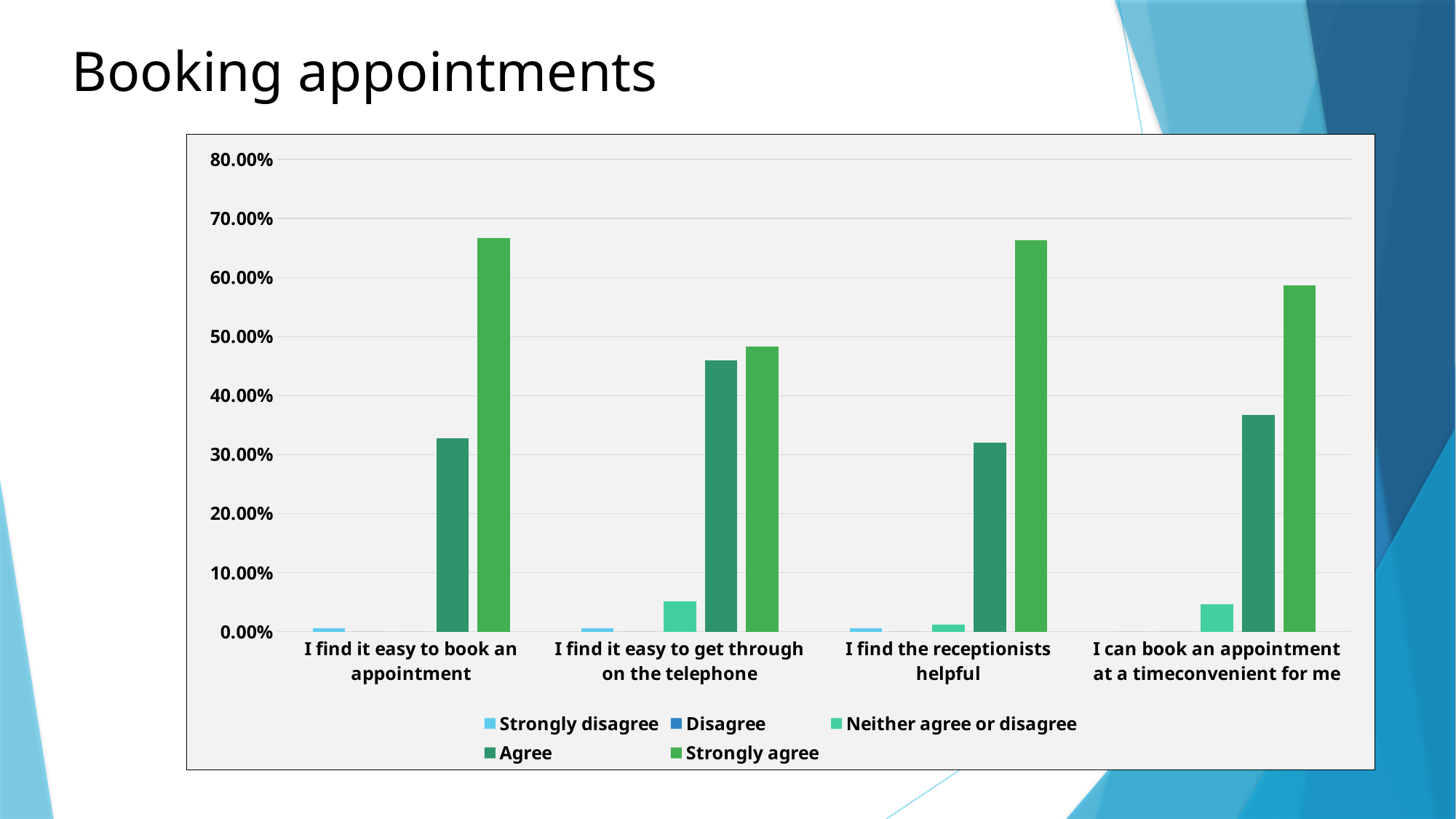
Which is larger for 'I find the receptionists helpful': the Agree value or the Strongly agree value? Strongly agree Is the Agree value for 'I find it easy to get through on the telephone' greater or less than 50.00%? less Which is larger: the Strongly agree value for 'I find it easy to get through on the telephone' or for 'I can book an appointment at a time convenient for me'? I can book an appointment at a time convenient for me Is the Neither agree or disagree value for 'I find it easy to get through on the telephone' greater or less than 10.00%? less For which statement is the Agree value highest? I find it easy to get through on the telephone Is the Strongly agree value for 'I find it easy to book an appointment' greater or less than 60.00%? greater How many series does the legend list? 5 For which statement is the Strongly agree value lowest? I find it easy to get through on the telephone What kind of chart is shown on the slide? bar chart How many statements (categories) are shown along the x axis? 4 What is the title of the slide containing the chart? Booking appointments